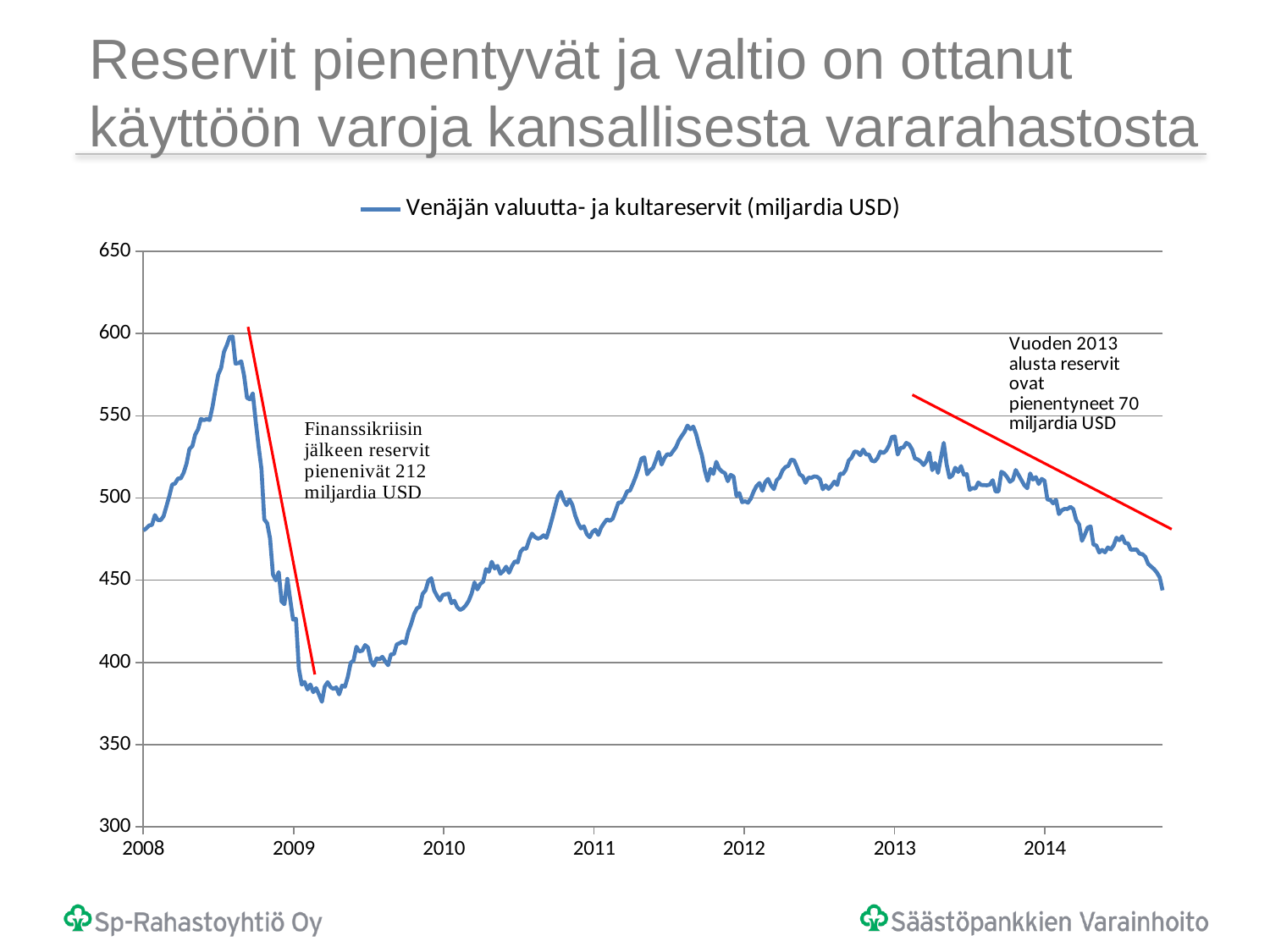
Is the value at the end of the series in 2014 greater or less than 500? less What is the name of the series shown in the legend? Venäjän valuutta- ja kultareservit (miljardia USD) Is the peak value reached in 2008 greater or less than 550? greater What kind of chart is shown on the slide? line chart Do the values rise or fall from the start of 2013 to the end of the series in 2014? fall Do the values rise or fall from early 2009 to mid-2011? rise According to the annotation on the chart, by how much did the reserves fall after the financial crisis? 212 miljardia USD How many year labels are shown on the x axis? 7 Is the value at the start of 2008 greater or less than 450? greater How many series does the legend list? 1